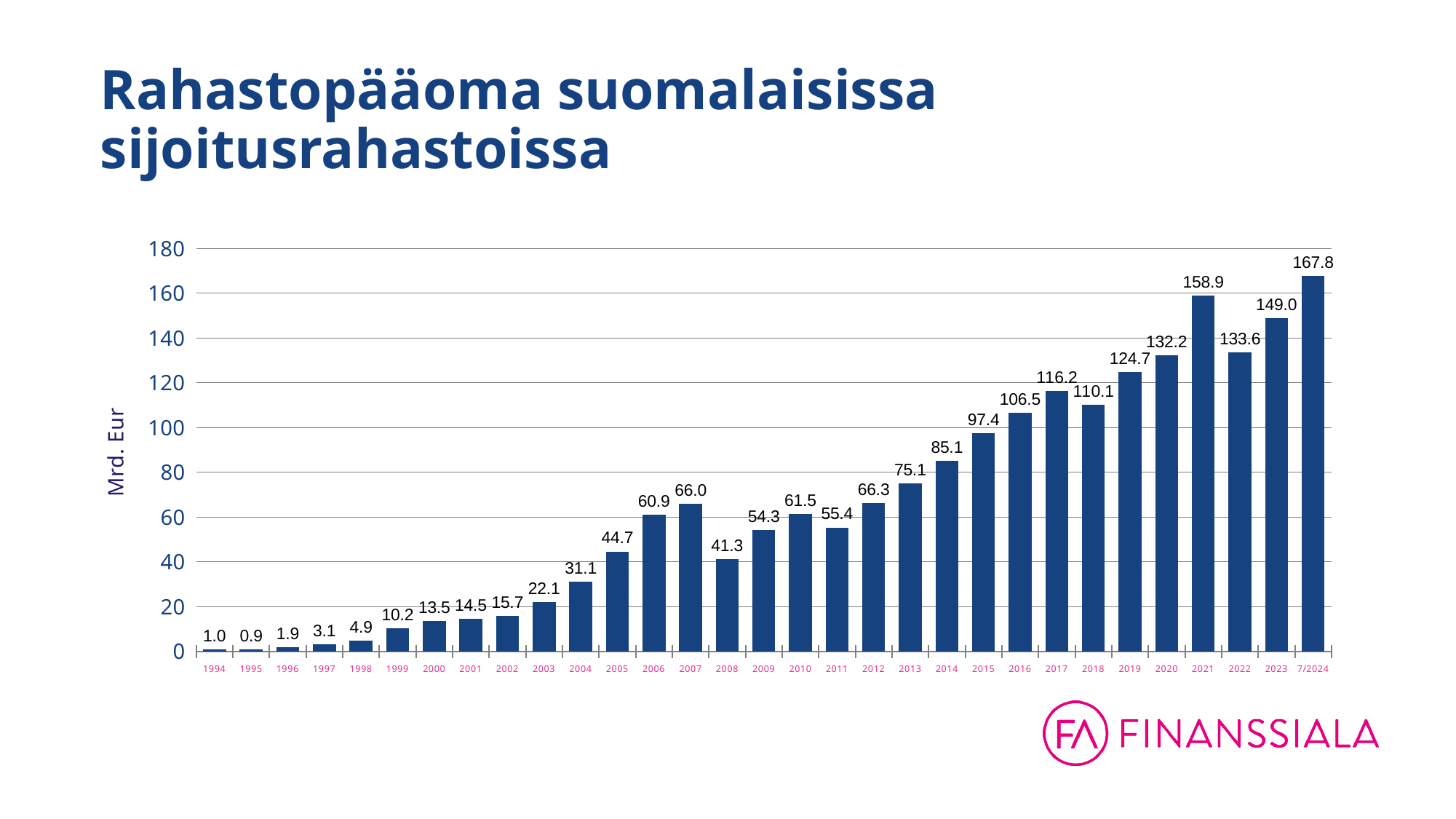
What is the label of the vertical axis? Mrd. Eur What is the value for 2008? 41.3 What is the value for 1999? 10.2 What is the difference between the values for 2021 and 2022? 25.3 Which is larger, the value for 2018 or the value for 2017? 2017 How many bars are shown in the chart? 31 Which year has the lowest value? 1995 What is the value for 7/2024? 167.8 What is the difference between the values for 2007 and 2008? 24.7 What is the value for 2021? 158.9 Which year has the highest value? 7/2024 What kind of chart is shown on the slide? Bar chart